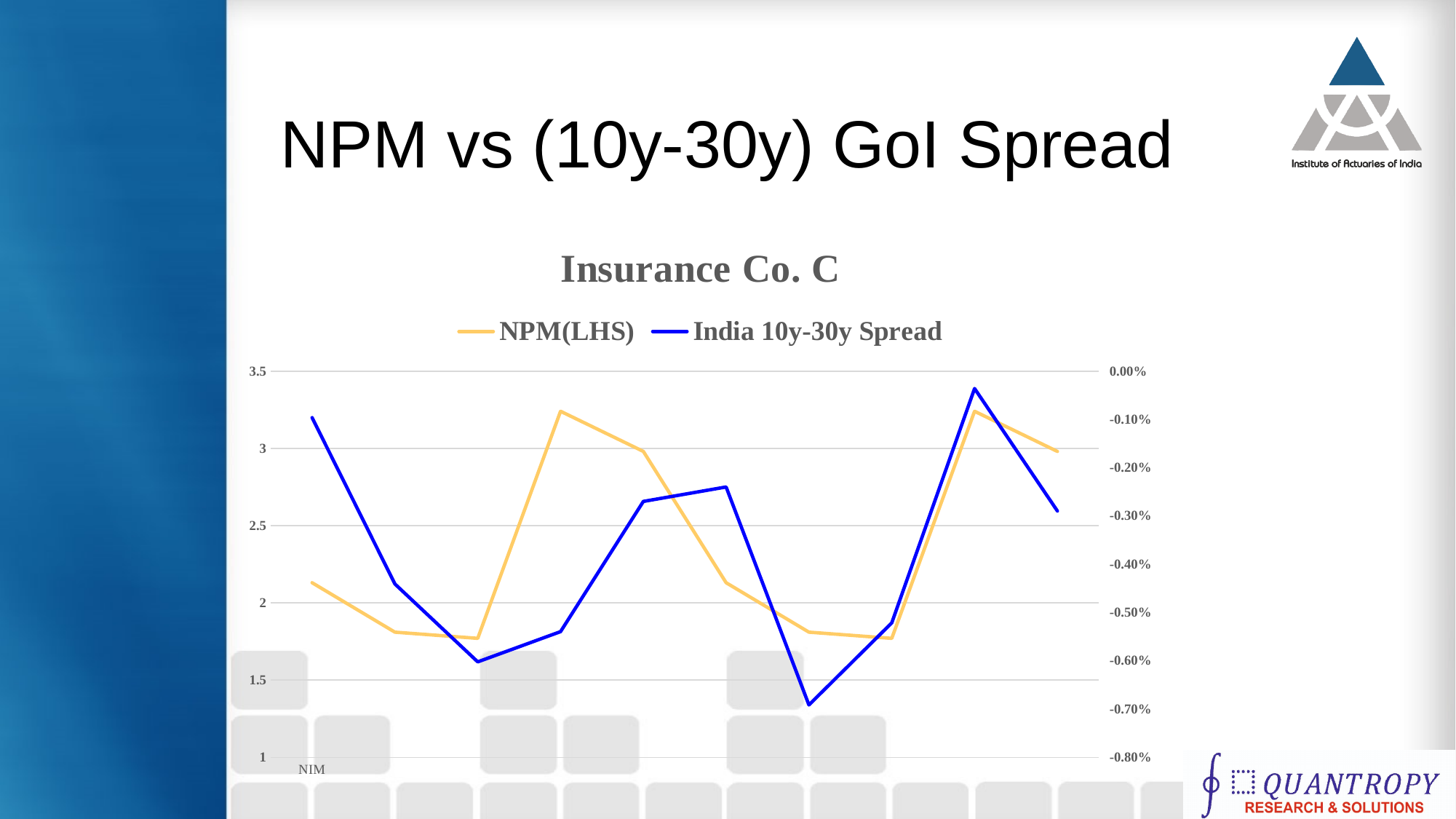
Is the first value of the NPM(LHS) line greater or less than 2.5? less Does the NPM(LHS) line rise or fall between its last two points? fall What is the title of the chart? Insurance Co. C Does the India 10y-30y Spread line rise or fall between its first and second points? fall Is the last value of the NPM(LHS) line greater or less than 2.5? greater Which series is drawn in blue? India 10y-30y Spread How many series does the chart legend list? 2 How many data points does each line in the chart have? 10 Does the NPM(LHS) line end higher or lower than it starts? higher Is the highest value of the India 10y-30y Spread line greater or less than -0.10%? greater What kind of chart is shown on the slide? line chart